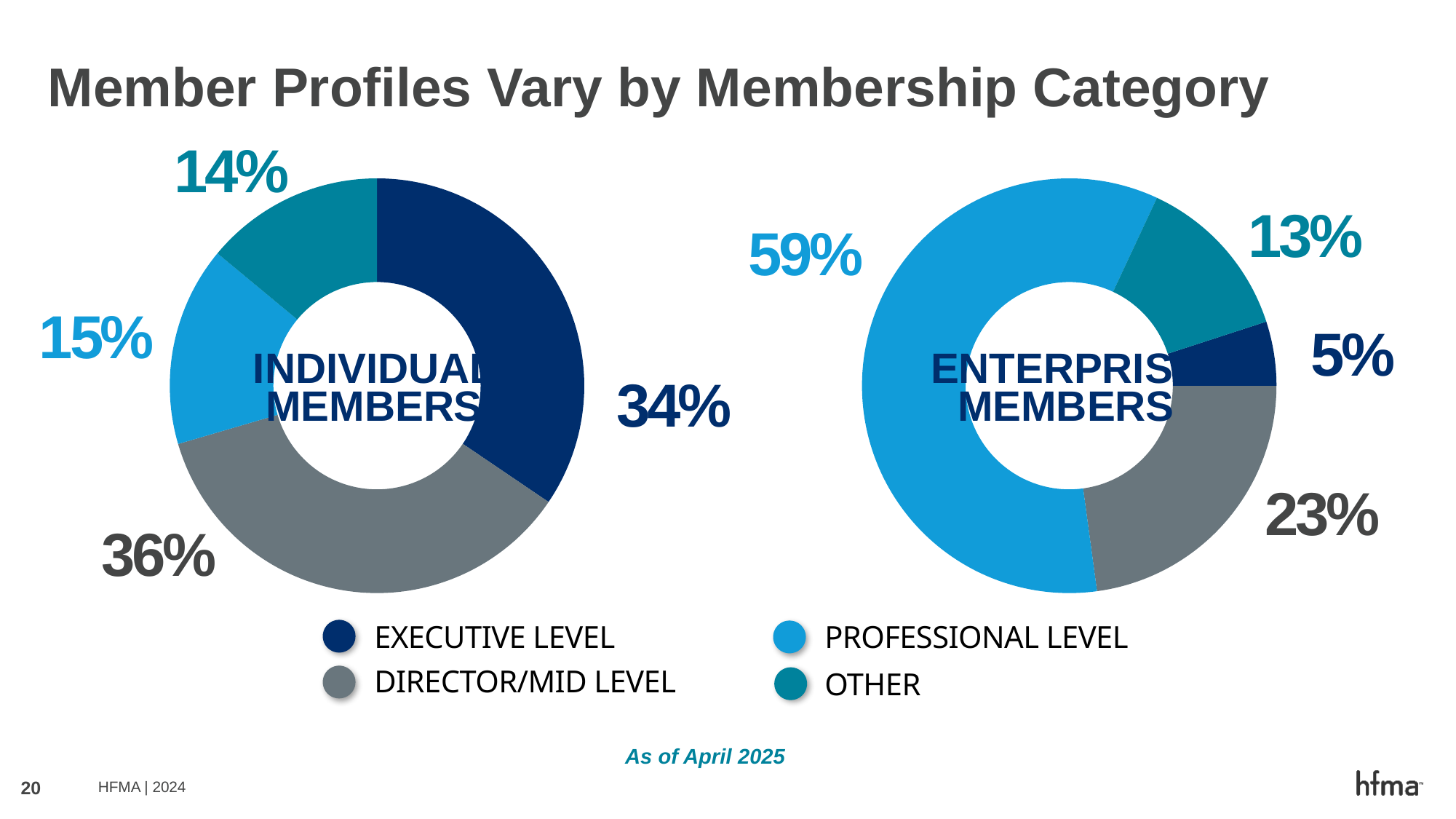
In the Enterprise Members chart, what share of members are Executive Level? 5% In the Individual Members chart, what share of members are Director/Mid Level? 36% What kind of chart is used for the Individual Members data? Pie (doughnut) chart In the Enterprise Members chart, what share of members are Professional Level? 59% In the Individual Members chart, which category has the smallest share? Other In the Individual Members chart, what share of members are Executive Level? 34% What is the title of the slide? Member Profiles Vary by Membership Category In the Enterprise Members chart, which category has the smallest share? Executive Level In the Individual Members chart, which is larger: the Director/Mid Level share or the Executive Level share? Director/Mid Level In the Enterprise Members chart, which category has the largest share? Professional Level How many categories does the legend list? 4 What is the difference between the Professional Level share in the Enterprise Members chart and the Professional Level share in the Individual Members chart? 44 percentage points